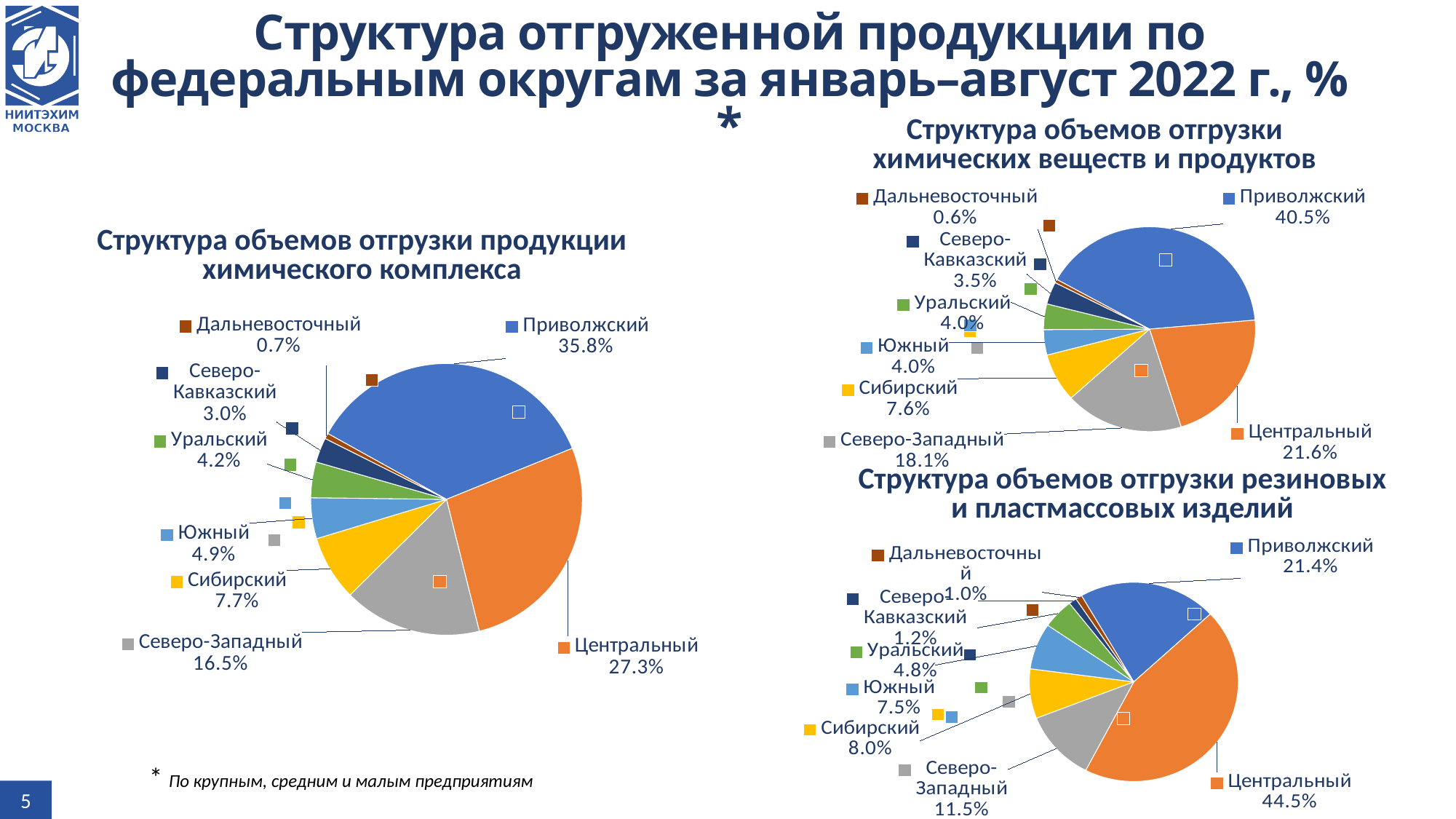
In the chart 'Структура объемов отгрузки резиновых и пластмассовых изделий', what share does Центральный have? 44.5% In the chart 'Структура объемов отгрузки химических веществ и продуктов', which region has the largest share? Приволжский In the chart 'Структура объемов отгрузки продукции химического комплекса', which region has the smallest share? Дальневосточный In the chart 'Структура объемов отгрузки химических веществ и продуктов', what share does Северо-Западный have? 18.1% In the chart 'Структура объемов отгрузки продукции химического комплекса', what is the difference between the shares of Центральный and Северо-Западный? 10.8% In the chart 'Структура объемов отгрузки химических веществ и продуктов', what is the share of Дальневосточный? 0.6% In the chart 'Структура объемов отгрузки продукции химического комплекса', which region has the largest share? Приволжский What type of chart is used for 'Структура объемов отгрузки продукции химического комплекса'? Pie chart In the chart 'Структура объемов отгрузки резиновых и пластмассовых изделий', what is the difference between the shares of Центральный and Приволжский? 23.1% In the chart 'Структура объемов отгрузки продукции химического комплекса', what share does Приволжский have? 35.8% How many regions (slices) are shown in the chart 'Структура объемов отгрузки резиновых и пластмассовых изделий'? 8 In the chart 'Структура объемов отгрузки резиновых и пластмассовых изделий', which is larger: Сибирский or Южный? Сибирский